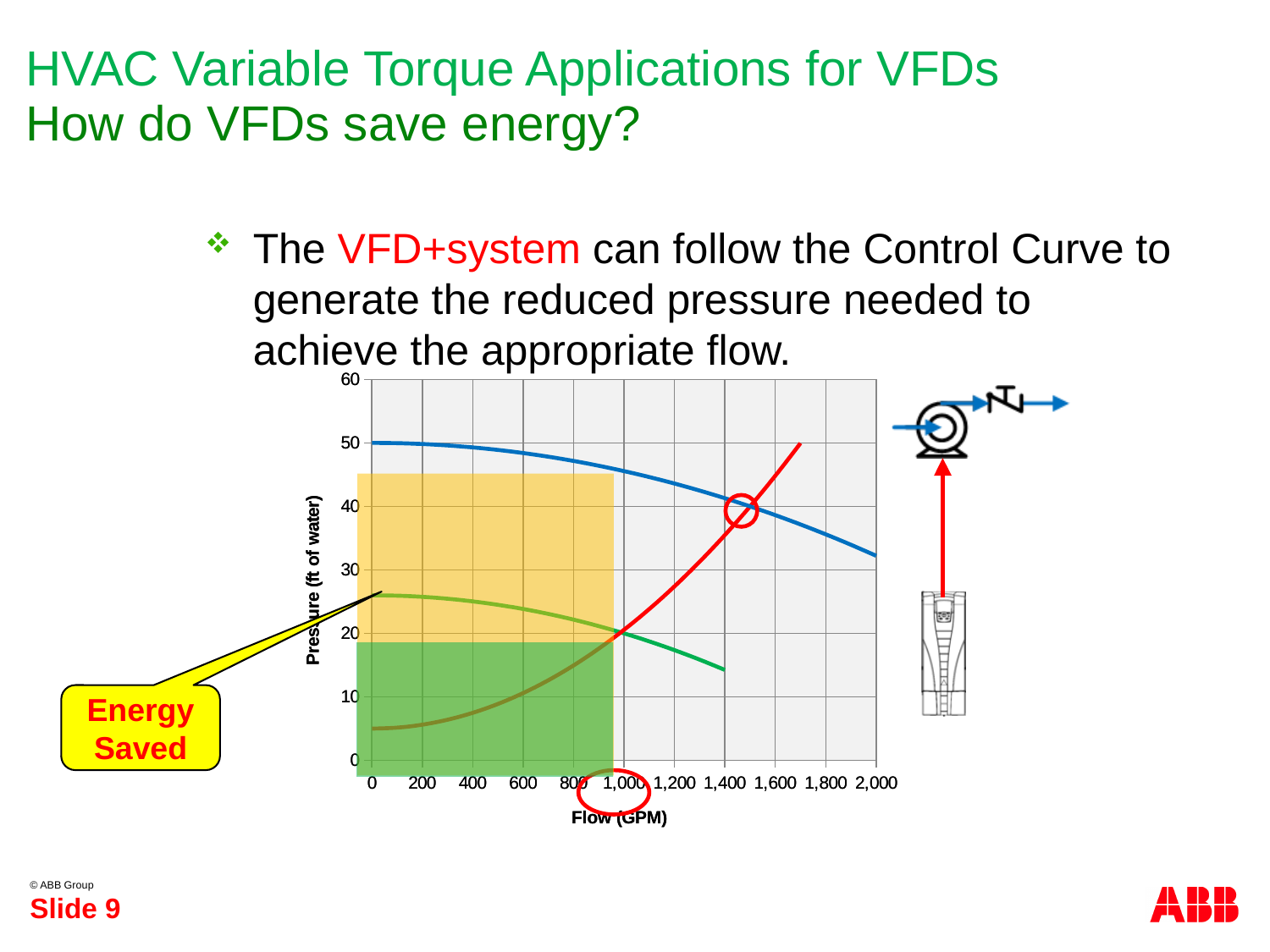
Is the pressure on the red curve at a flow of 1,000 GPM greater or less than 30? less Is the pressure on the brown curve at a flow of 0 GPM greater or less than 10? less Is the pressure on the blue curve at a flow of 0 GPM greater or less than 40? greater What is the title of the vertical axis of the chart? Pressure (ft of water) How many curves are plotted on the chart? 4 What kind of chart is shown on the slide? line chart What is the title of the horizontal axis of the chart? Flow (GPM) Does the blue curve rise or fall as flow increases along the x axis? fall At a flow of 1,000 GPM, which curve shows the higher pressure, the blue curve or the green curve? the blue curve Does the red curve rise or fall as flow increases along the x axis? rise